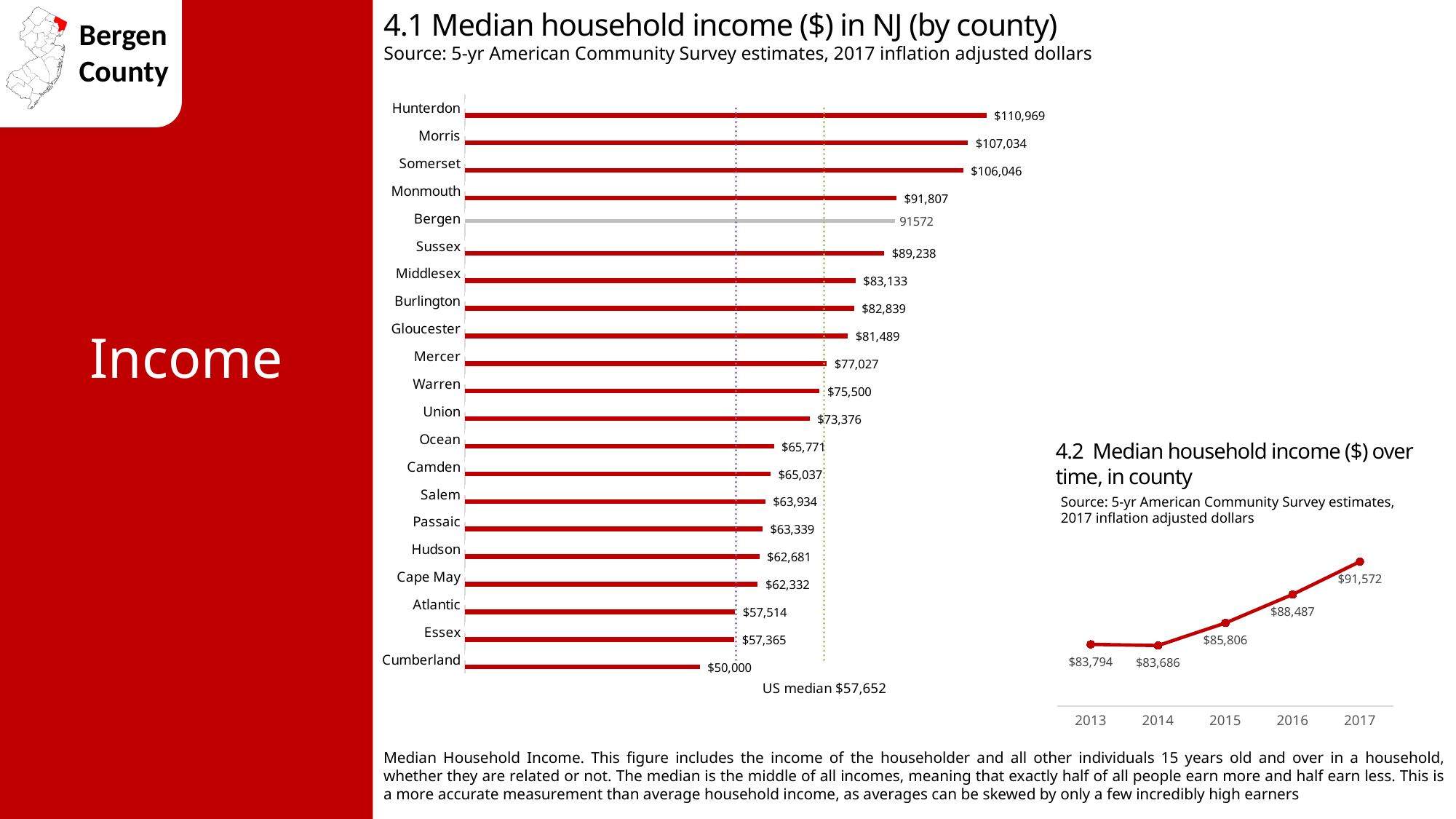
In chart 4.1, which county has the lowest median household income? Cumberland In chart 4.2, what is the difference between the median household income in 2017 and 2013? $7,778 In chart 4.1, what US median value is noted below the bars? $57,652 In chart 4.1, what is the difference between the median household income of Hunterdon and Cumberland? $60,969 In chart 4.1, how many counties are shown? 21 In chart 4.1, which county has the highest median household income? Hunterdon In chart 4.1, what is the median household income for Hunterdon? $110,969 In chart 4.2, does the median household income rise or fall from 2014 to 2017? Rise What kind of chart is chart 4.1? Bar chart In chart 4.1, what is the median household income for Cumberland? $50,000 In chart 4.2, what is the median household income for 2015? $85,806 In chart 4.1, which county has a higher median household income, Monmouth or Sussex? Monmouth